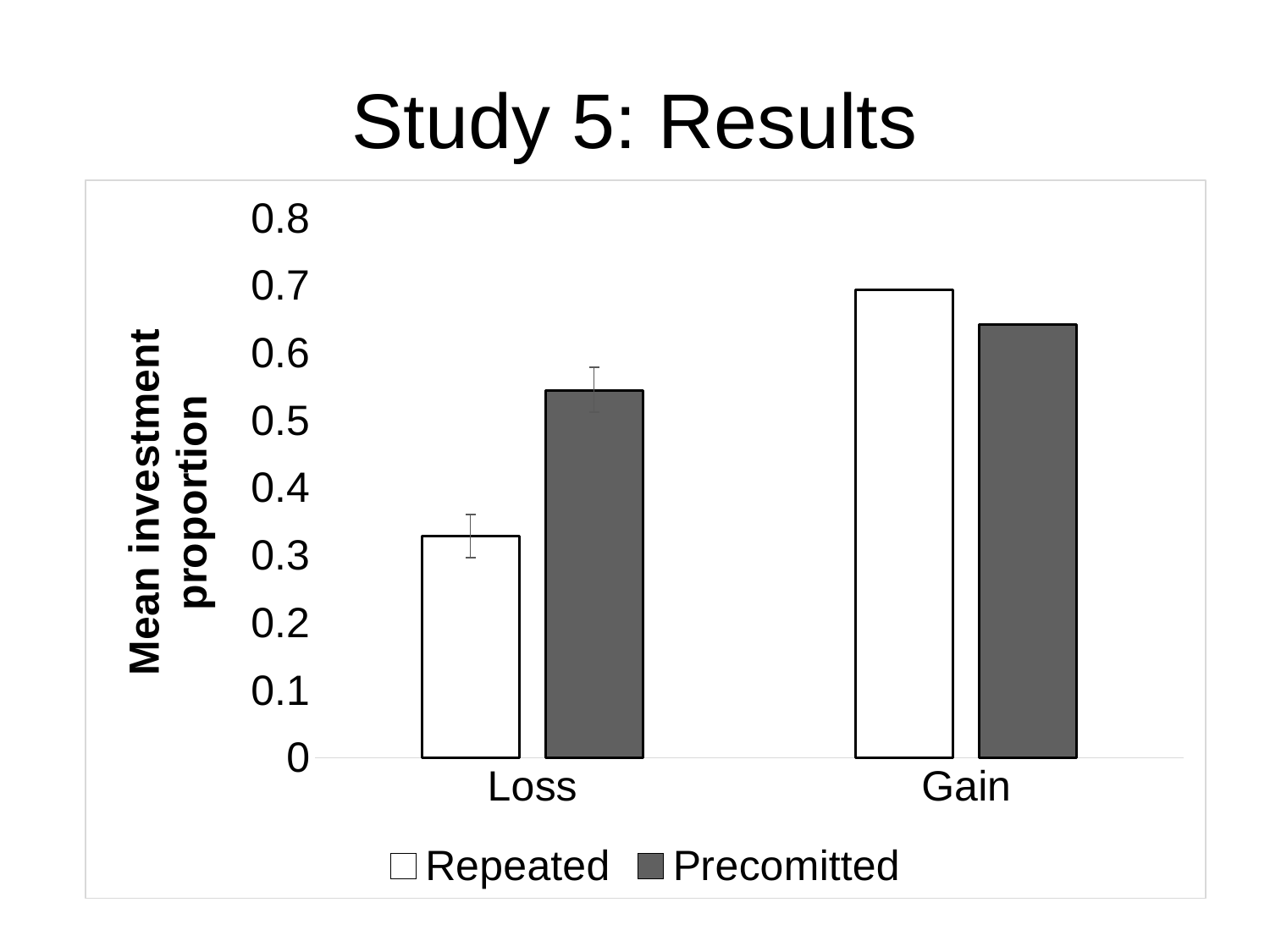
What is the label of the y axis? Mean investment proportion Is the Repeated value for Loss greater or less than 0.4? less Is the Precomitted value for Gain greater or less than 0.7? less How many categories are shown on the x axis? 2 What kind of chart is shown on the slide? bar chart Is the Repeated value for Gain greater or less than 0.6? greater Which bar is the shortest in the chart? Repeated in Loss How many series does the legend list? 2 Which bar is the tallest in the chart? Repeated in Gain In the Loss condition, which series has the larger value, Repeated or Precomitted? Precomitted In the Gain condition, which series has the larger value, Repeated or Precomitted? Repeated